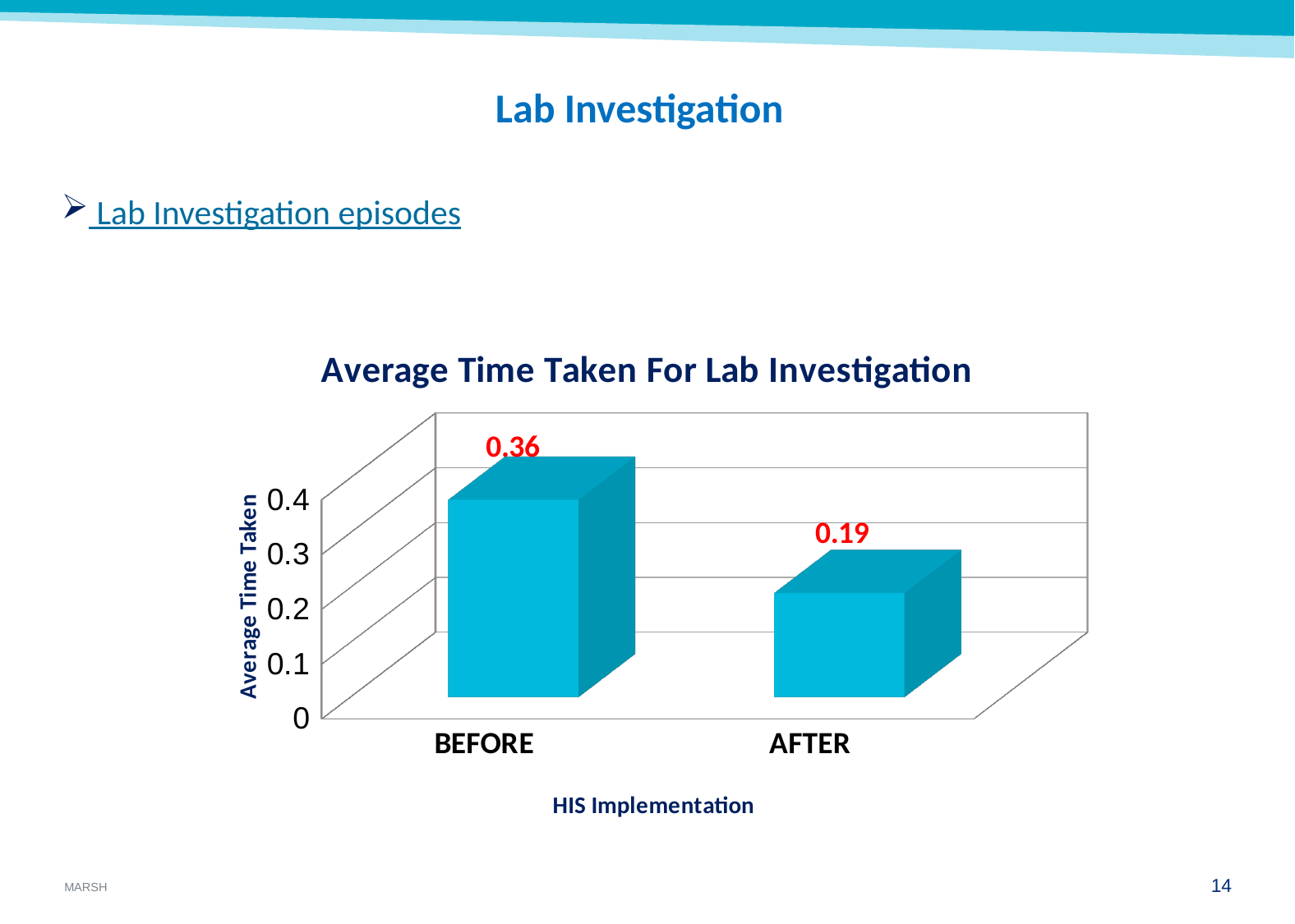
Which category has the lowest average time taken? AFTER What is the title of the chart? Average Time Taken For Lab Investigation What is the average time taken for lab investigation AFTER HIS implementation? 0.19 Is the value for BEFORE greater or less than 0.3? greater What is the average time taken for lab investigation BEFORE HIS implementation? 0.36 Which category has the highest average time taken? BEFORE What kind of chart is shown on the slide? bar chart How many categories are shown on the x axis? 2 Which is larger, the value for BEFORE or the value for AFTER? BEFORE What is the difference between the BEFORE and AFTER values? 0.17 Do the values rise or fall from BEFORE to AFTER? fall Is the value for AFTER greater or less than 0.2? less